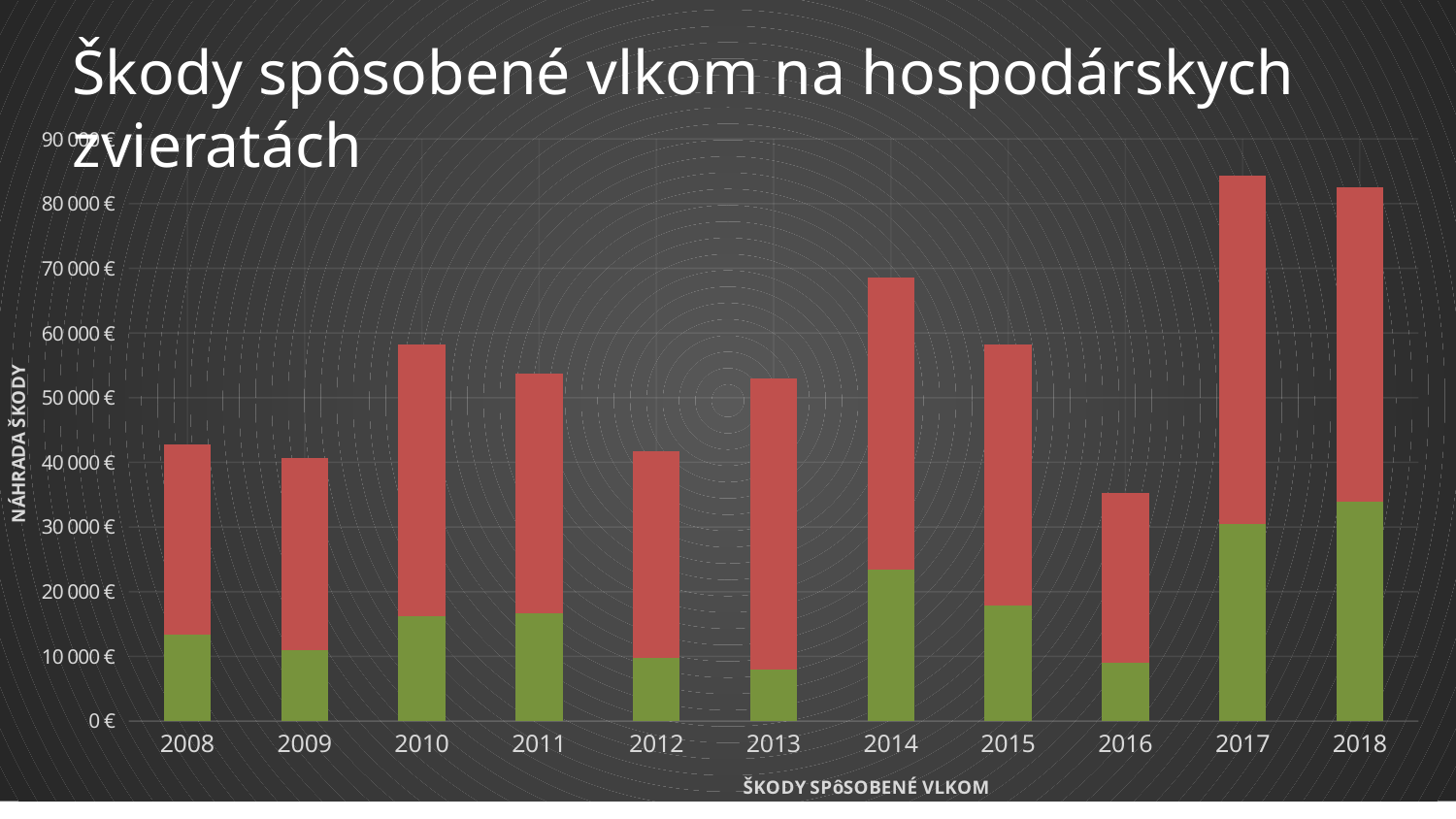
Is the total value for 2012 greater or less than 50 000 €? less What is the title of the horizontal axis of the chart? ŠKODY SPÔSOBENÉ VLKOM Which year has the larger total bar, 2014 or 2015? 2014 What kind of chart is shown on the slide? stacked bar chart Is the green segment for 2018 greater or less than 30 000 €? greater Is the total value for 2016 greater or less than 40 000 €? less What is the title of the vertical axis of the chart? NÁHRADA ŠKODY Which year has the lowest total bar in the chart? 2016 How many years are shown on the x axis of the chart? 11